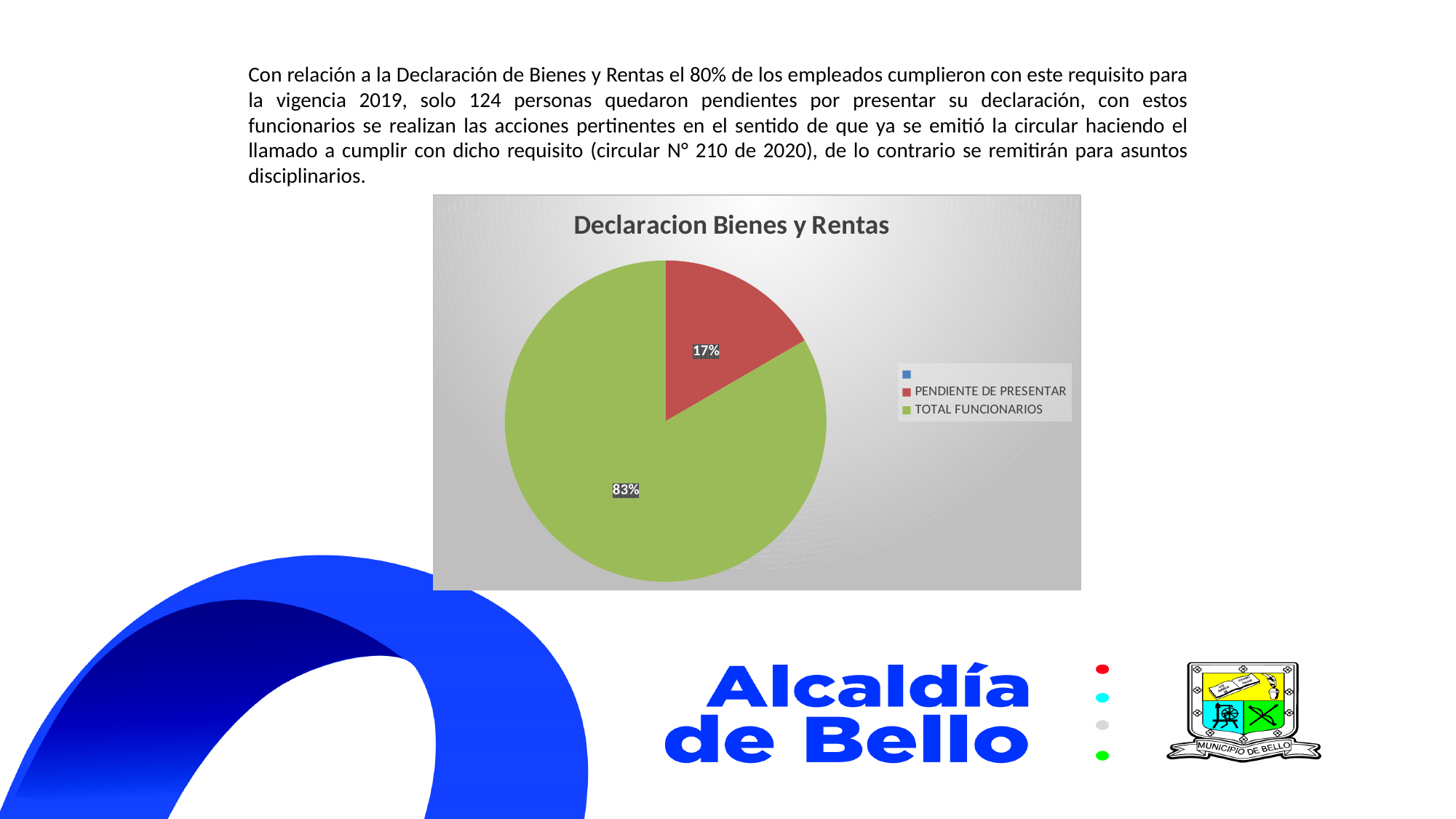
What share of the pie does TOTAL FUNCIONARIOS represent? 83% What kind of chart is shown on the slide? pie chart What is the title of the chart? Declaracion Bienes y Rentas What colour is the PENDIENTE DE PRESENTAR slice? red Which is larger, the PENDIENTE DE PRESENTAR slice or the TOTAL FUNCIONARIOS slice? TOTAL FUNCIONARIOS How many labelled slices are visible in the pie chart? 2 Which slice of the pie is the largest? TOTAL FUNCIONARIOS What share of the pie does PENDIENTE DE PRESENTAR represent? 17% Which slice of the pie is the smallest? PENDIENTE DE PRESENTAR What is the difference in percentage points between the TOTAL FUNCIONARIOS slice and the PENDIENTE DE PRESENTAR slice? 66 percentage points